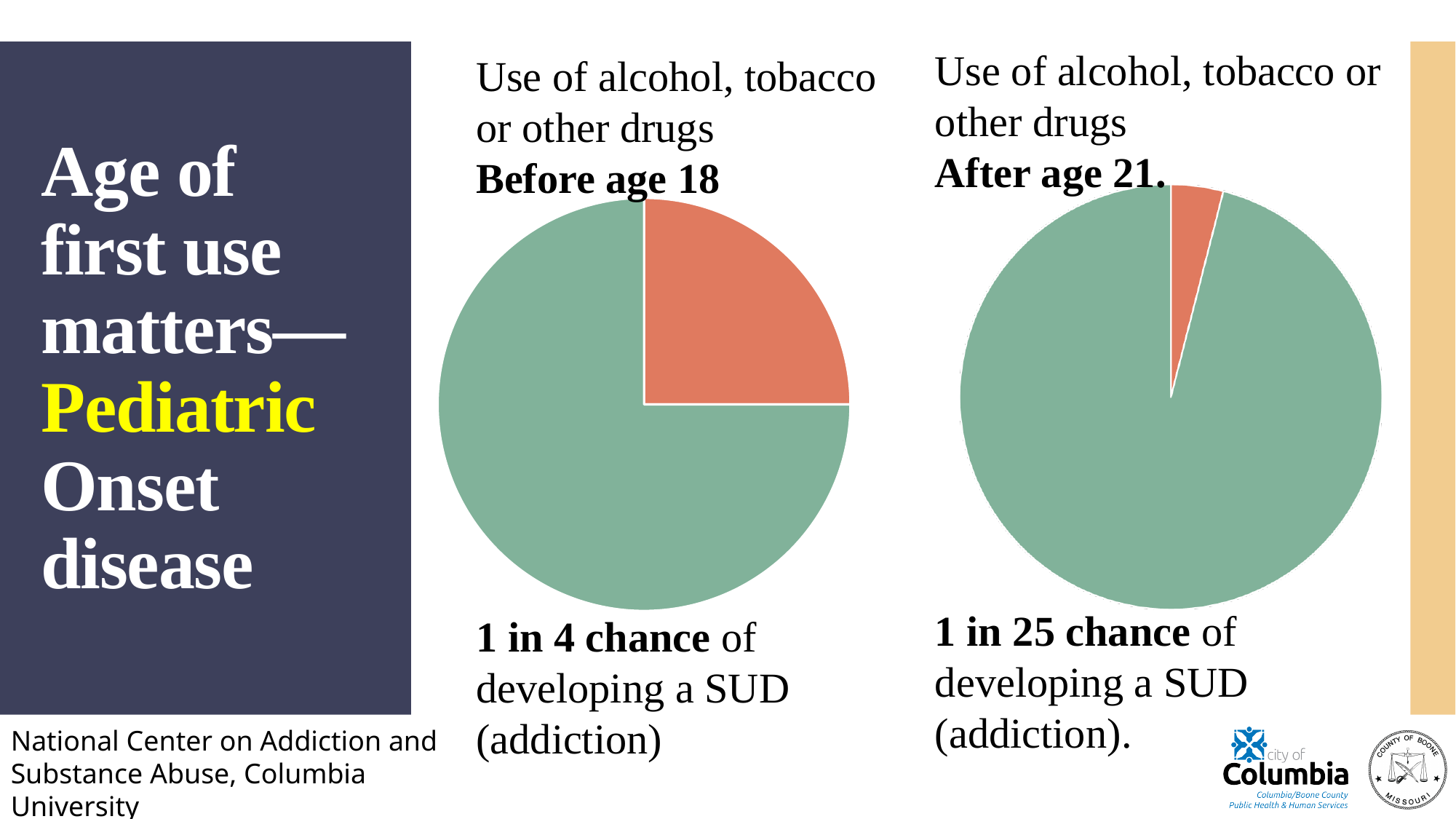
What kind of chart is used on the left side of the slide, under "Before age 18"? pie chart How many slices does the left pie chart (Before age 18) have? 2 In the right pie chart (After age 21), which slice is smaller, the green one or the orange one? the orange one In the left pie chart (Before age 18), which slice is larger, the green one or the orange one? the green one How many pie charts are shown on the slide? 2 What colour is the slice representing the chance of developing a SUD in both pie charts? orange In the right pie chart (After age 21), what chance of developing a SUD does the orange slice represent? 1 in 25 What kind of chart is used on the right side of the slide, under "After age 21"? pie chart Which pie chart has the larger orange slice, the one for Before age 18 or the one for After age 21? Before age 18 What age threshold is given in the heading above the right pie chart? After age 21 How many slices does the right pie chart (After age 21) have? 2 In the left pie chart (Before age 18), what chance of developing a SUD does the orange slice represent? 1 in 4